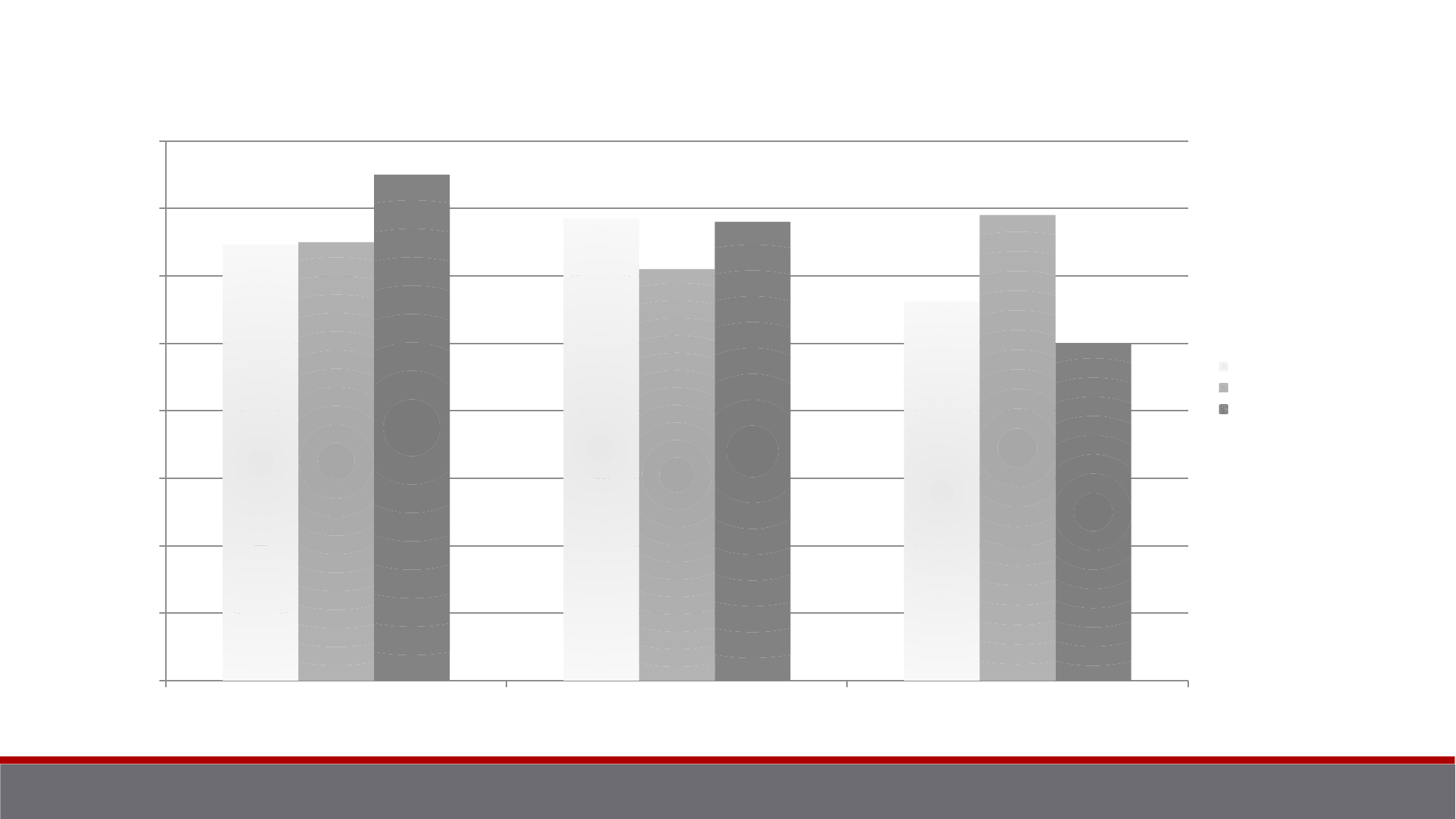
Where is the legend positioned relative to the plot area? to the right Are the bars on the chart vertical or horizontal? vertical Does the darkest series rise or fall from the left group to the right group? fall Which group of bars contains the single tallest bar on the chart: the left, middle, or right group? the left group What kind of chart is shown on the slide? bar chart In the middle group of bars, which bar is the shortest: the lightest, the medium grey, or the darkest? the medium grey In the leftmost group of bars, which bar is the tallest: the lightest, the medium grey, or the darkest? the darkest How many groups of bars (categories) are plotted along the x axis? 3 How many bars are plotted in total on the chart? 9 In the rightmost group of bars, which bar is the shortest: the lightest, the medium grey, or the darkest? the darkest How many series does the legend list? 3